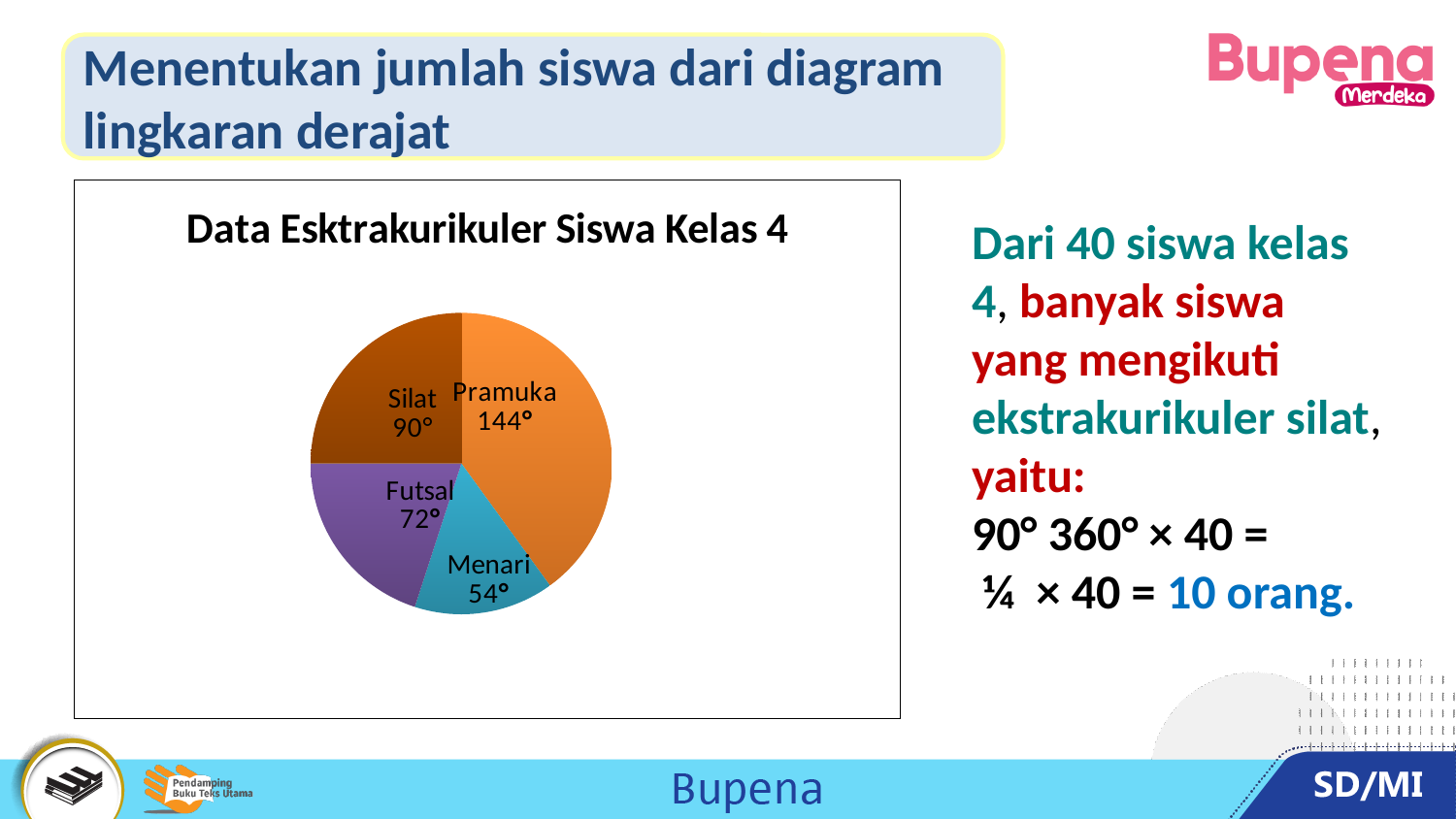
How many slices does the pie chart have? 4 What is the difference between the values for Pramuka and Silat? 54° What kind of chart is shown on the slide? pie chart Which extracurricular activity has the largest slice? Pramuka What is the value shown for Pramuka? 144° What share of the whole pie does the Pramuka slice represent? 40% What is the title of the chart? Data Esktrakurikuler Siswa Kelas 4 Which is larger, the slice for Silat or the slice for Futsal? Silat What is the value shown for Silat? 90° What is the value shown for Menari? 54° What share of the whole pie does the Silat slice represent? 25% Which extracurricular activity has the smallest slice? Menari